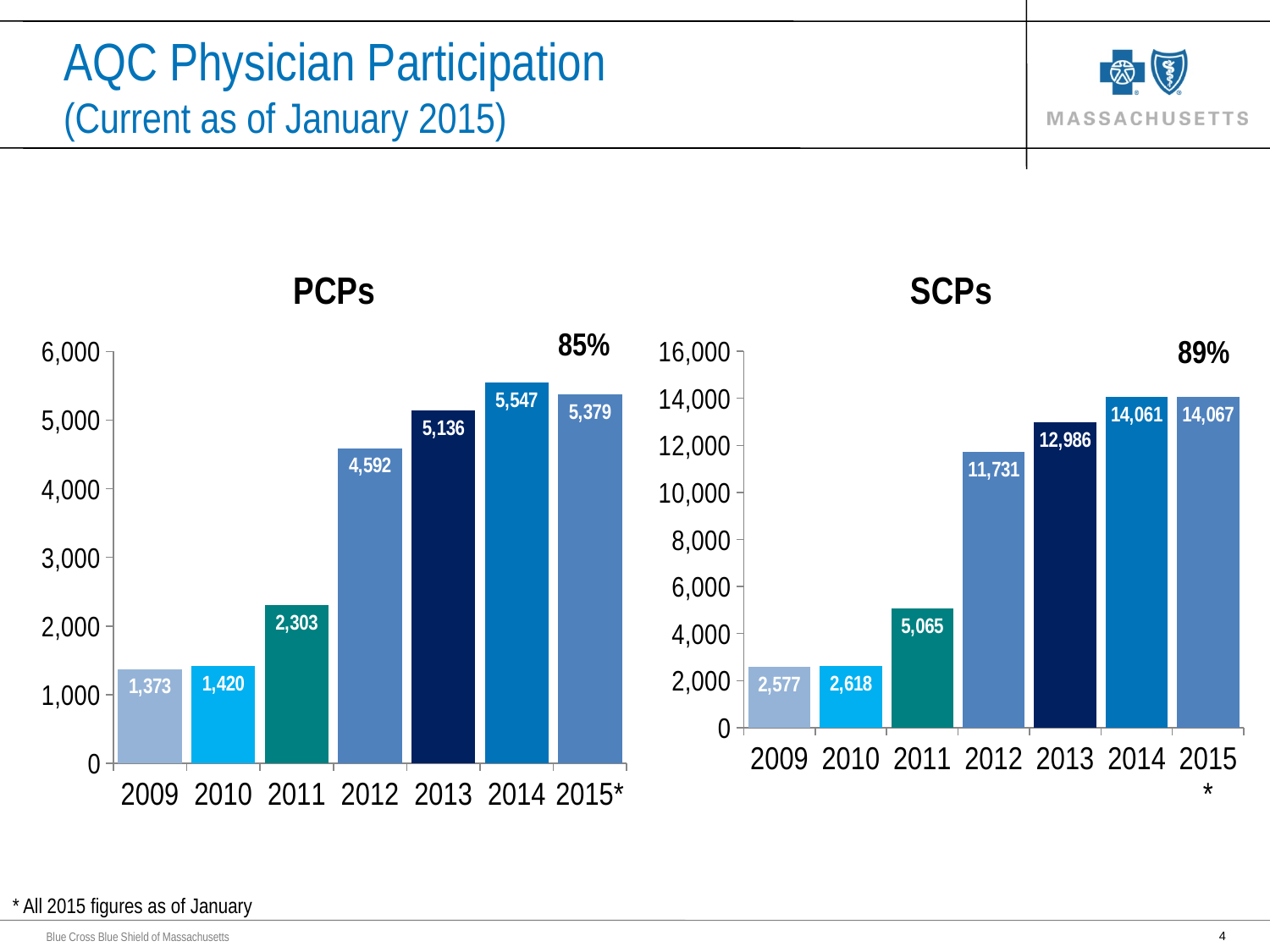
What percentage is printed at the top right of the SCPs chart? 89% What kind of chart is the PCPs chart? bar chart In the PCPs chart, what is the value for 2012? 4,592 In the SCPs chart, which year has the lowest value? 2009 In the SCPs chart, is the value for 2013 greater or less than 12,000? greater In the PCPs chart, what is the difference between the 2014 and 2015* values? 168 In the PCPs chart, which year has the highest value? 2014 In the SCPs chart, what is the difference between the 2012 and 2011 values? 6,666 In the SCPs chart, what is the value for 2011? 5,065 In the PCPs chart, which is larger, the value for 2013 or the value for 2015*? 2015* How many years are shown on the x axis of the SCPs chart? 7 In the SCPs chart, do the values generally rise or fall from 2009 to 2015? rise